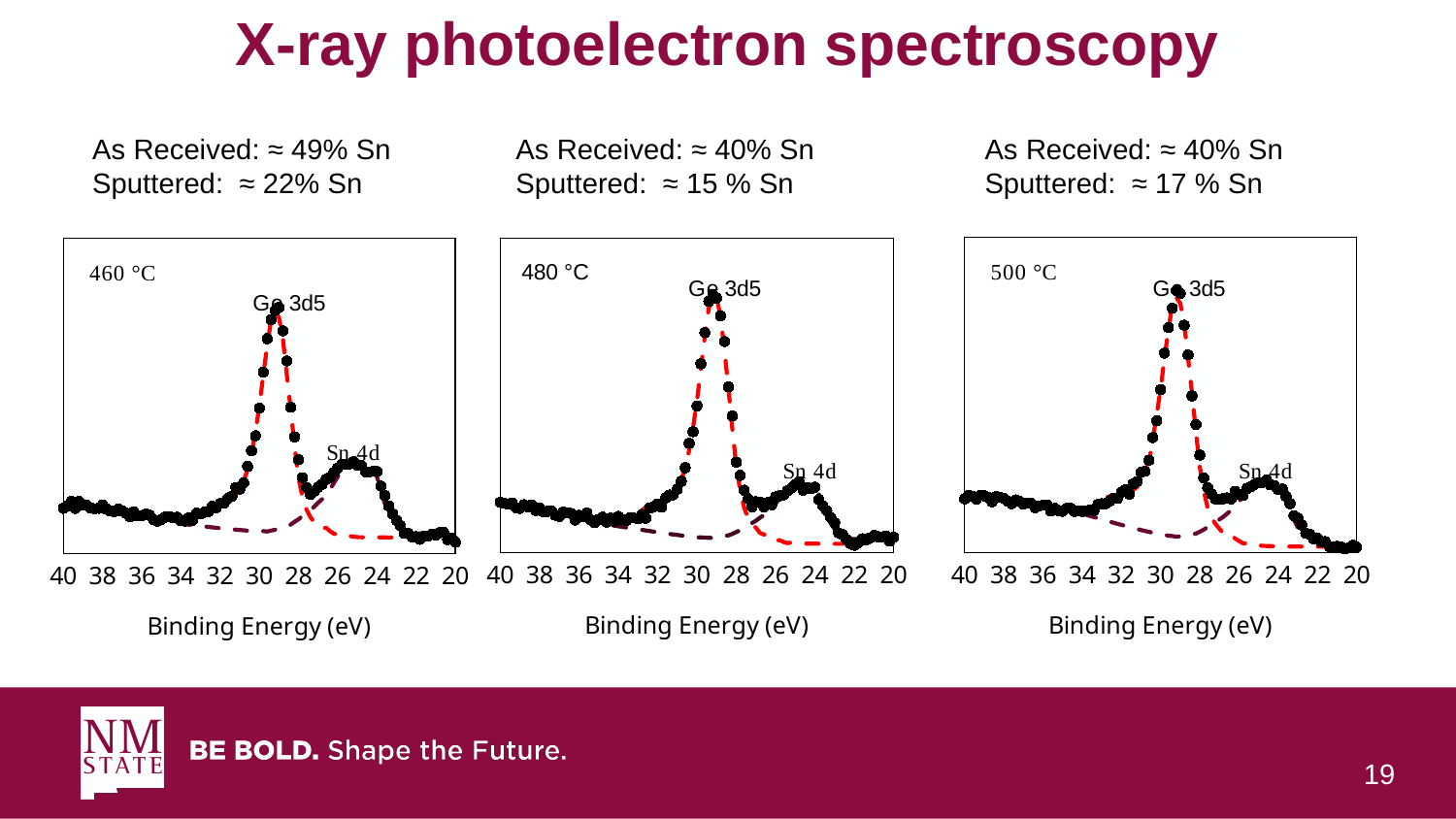
In the right-hand chart labelled 500 °C, which peak is taller, Ge 3d5 or Sn 4d? Ge 3d5 What is the lowest binding energy tick shown on the x axis of the left-hand chart labelled 460 °C? 20 In the right-hand chart labelled 500 °C, is the binding energy of the Ge 3d5 peak greater or less than 26 eV? greater In the middle chart labelled 480 °C, which labelled peak has the lowest intensity? Sn 4d What kind of chart is the left-hand chart labelled 460 °C? Scatter plot with fitted dashed curves What is the x-axis label of the middle chart labelled 480 °C? Binding Energy (eV) In the left-hand chart labelled 460 °C, is the binding energy of the Sn 4d peak greater or less than 28 eV? less What is the highest binding energy tick shown on the x axis of the right-hand chart labelled 500 °C? 40 What temperature is printed inside the middle chart? 480 °C In the left-hand chart labelled 460 °C, which labelled peak has the highest intensity? Ge 3d5 How many labelled peaks are marked in the middle chart labelled 480 °C? 2 How many charts are shown on the slide? 3